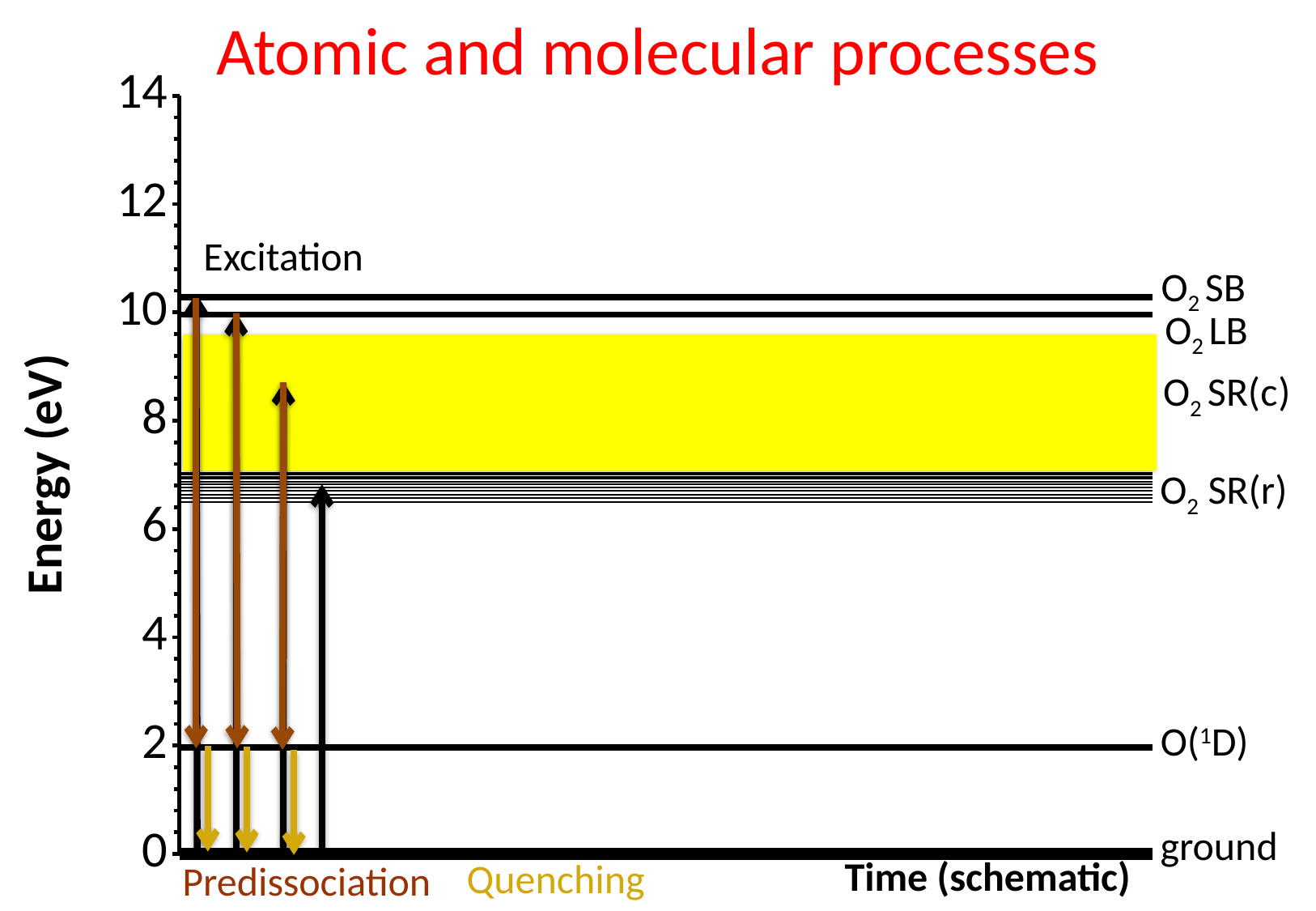
At what energy in eV is the ground level drawn? 0 At what energy in eV is the O(1D) level drawn? 2 Is the energy of the O2 SR(r) level greater or less than 8 eV? less Is the energy of the O2 SB level greater or less than 10 eV? greater Which level has the higher energy, O2 SB or O(1D)? O2 SB Is the energy of the O2 SR(r) level greater or less than 6 eV? greater How many labelled energy levels are shown on the right side of the chart? 6 What kind of chart is shown on the slide? Energy level diagram What is the label of the vertical axis? Energy (eV) Which labelled energy level is the highest? O2 SB What is the title of the chart? Atomic and molecular processes Which labelled energy level is the lowest? ground